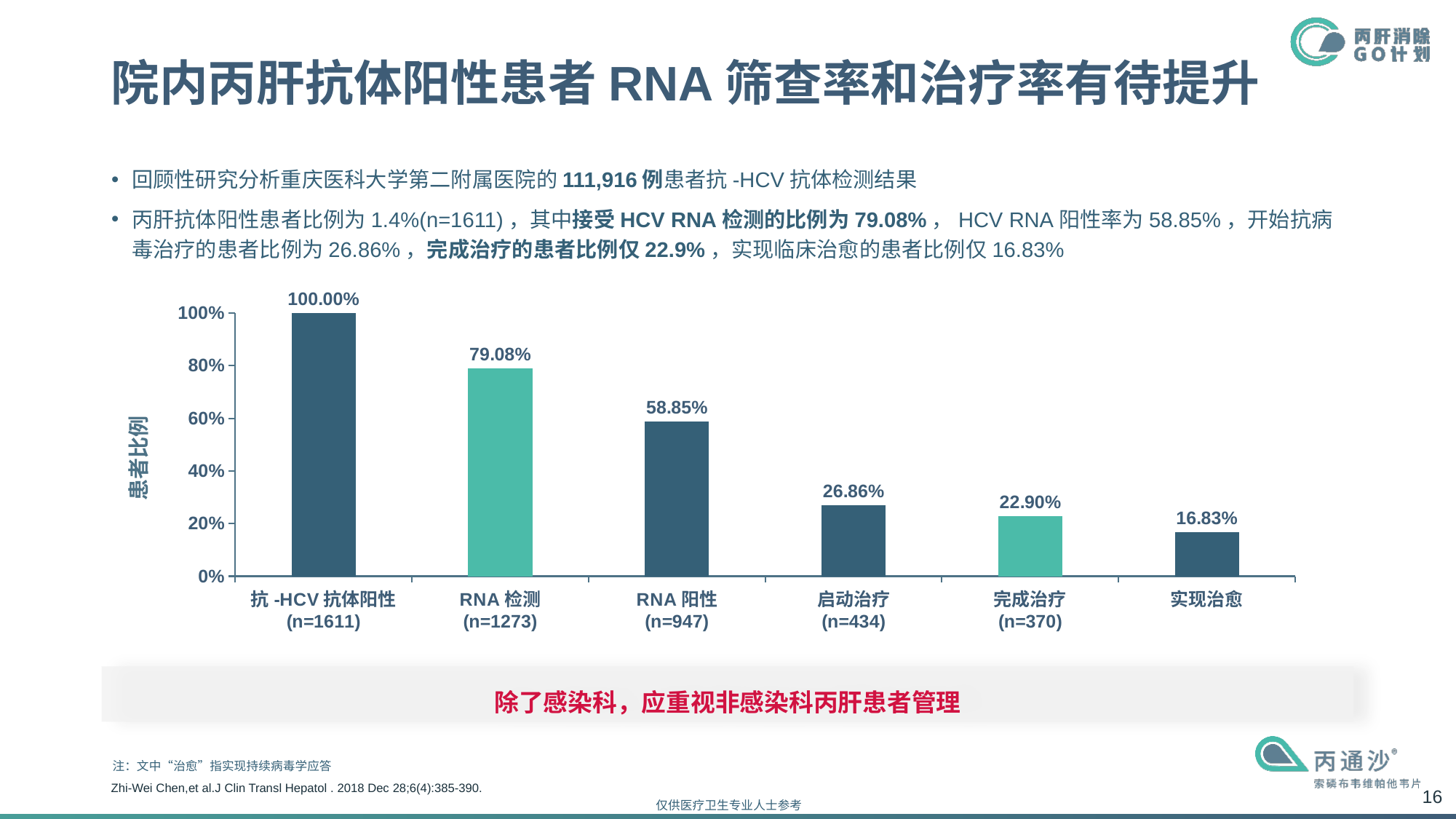
What is the value for 实现治愈? 16.83% Which category has the lowest value? 实现治愈 What is the value for RNA 检测 (n=1273)? 79.08% What is the value for 完成治疗 (n=370)? 22.90% What is the difference between the values for 启动治疗 and 完成治疗? 3.96% Which category has the highest value? 抗-HCV 抗体阳性 (n=1611) What is the difference between the values for RNA 检测 and RNA 阳性? 20.23% What kind of chart is shown on the slide? bar chart Which is larger, the value for 启动治疗 or the value for 实现治愈? 启动治疗 Do the values rise or fall from left to right along the x axis? fall How many categories are shown on the x axis? 6 Is the value for RNA 阳性 greater or less than 60%? less